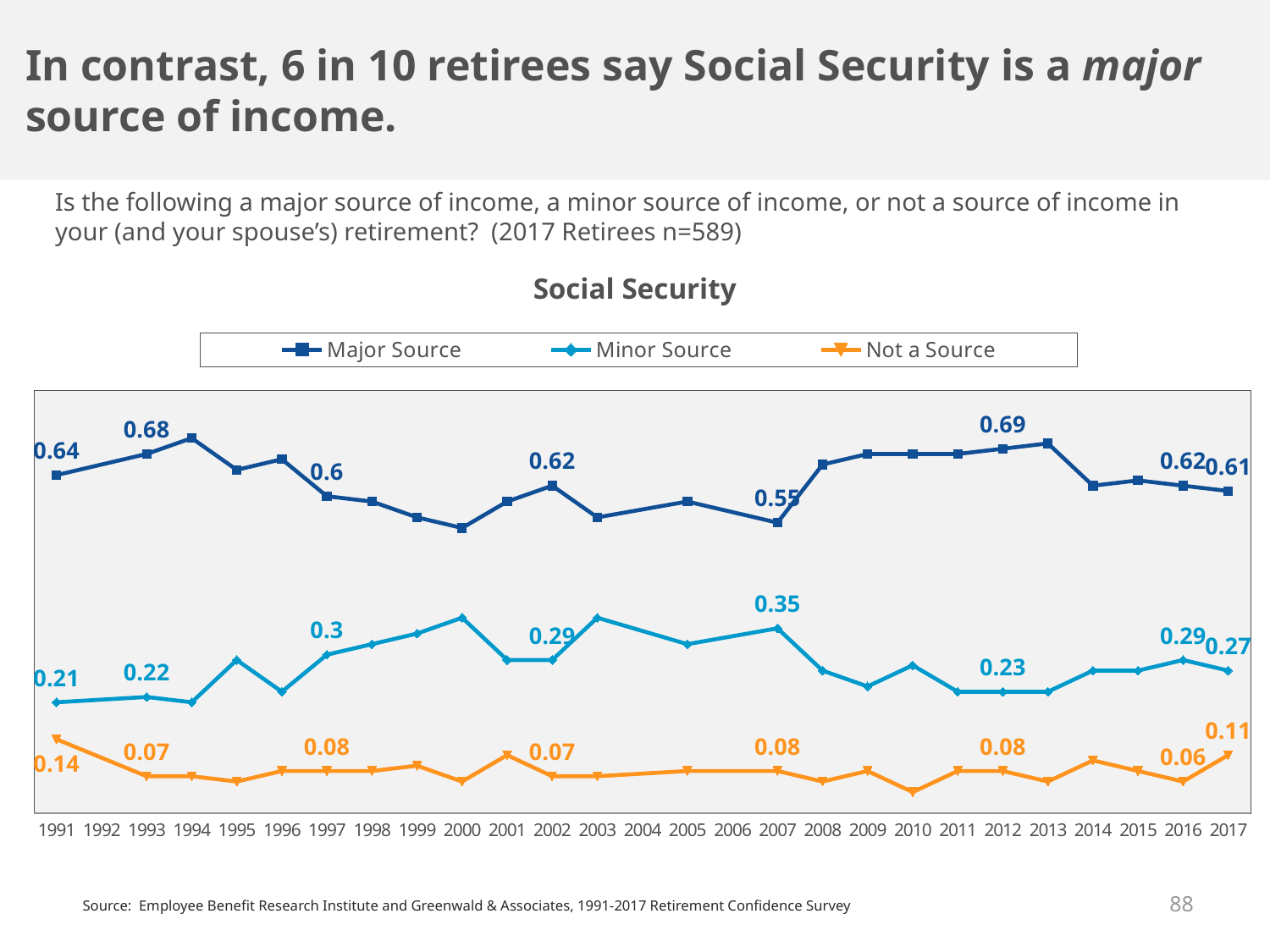
What is the value for Major Source in 1991? 0.64 How many series does the legend list? 3 What is the title of the chart? Social Security Which is larger in 2007, the Major Source value or the Minor Source value? Major Source What is the value for Not a Source in 2017? 0.11 What kind of chart is shown? Line chart What is the value for Minor Source in 2007? 0.35 How many years are shown on the x axis? 27 What is the difference between the Major Source and Minor Source values in 2017? 0.34 What is the value for Minor Source in 1997? 0.3 What is the difference between the Not a Source values in 1991 and 1993? 0.07 What is the value for Major Source in 2012? 0.69